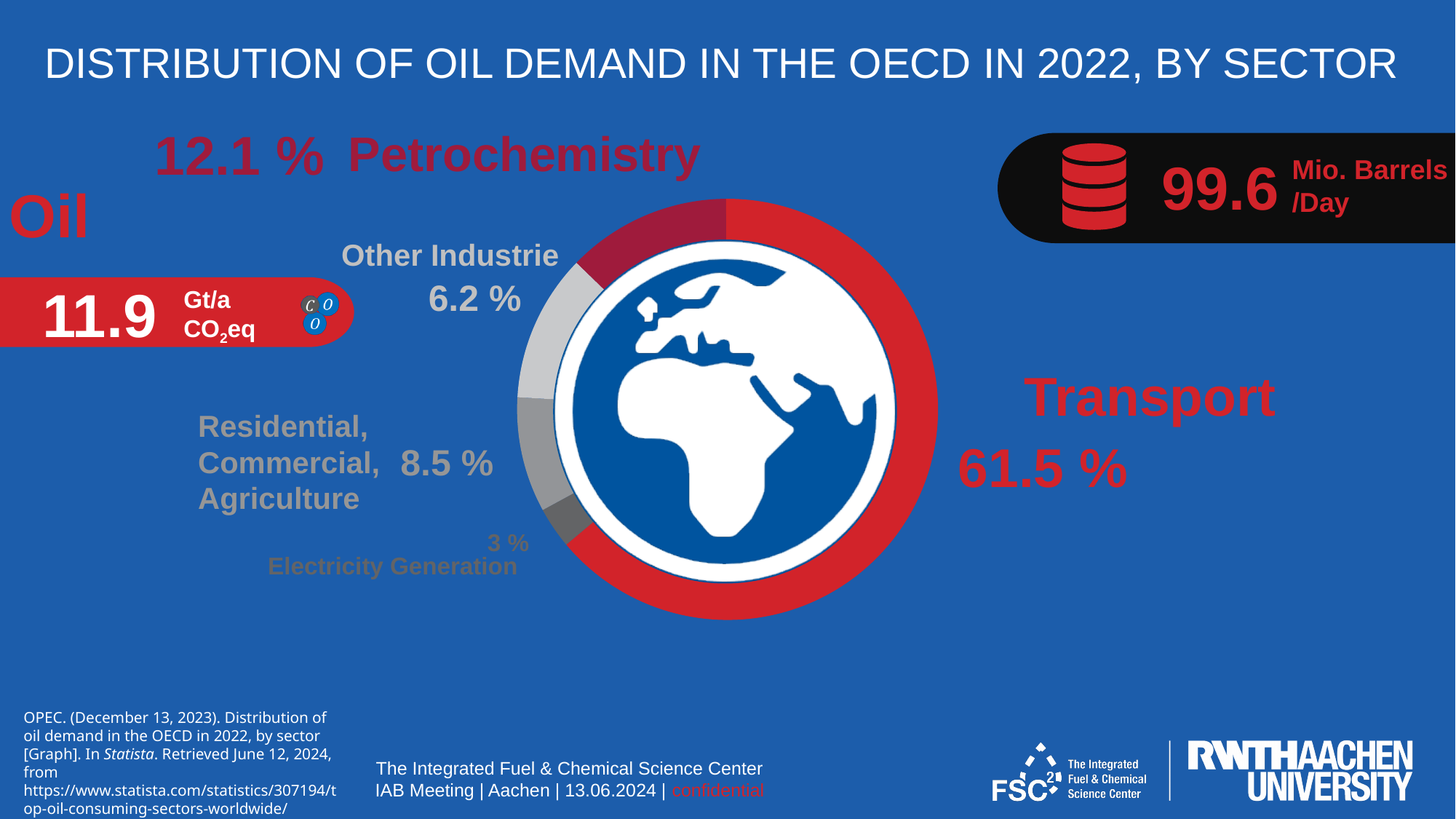
Which has a larger share: Other Industrie or Residential, Commercial, Agriculture? Residential, Commercial, Agriculture What share of OECD oil demand in 2022 does the Transport sector account for? 61.5 % How many percentage points larger is the Transport share than the Petrochemistry share? 49.4 % What daily oil volume in million barrels per day is shown on the slide? 99.6 What percentage is shown for Electricity Generation? 3 % How many sectors are shown in the chart? 5 What percentage is shown for Petrochemistry? 12.1 % Which sector has the largest share of oil demand in the chart? Transport What kind of chart is used to show the distribution of oil demand? Pie chart (donut) Which sector has the smallest share of oil demand in the chart? Electricity Generation What percentage is shown for Residential, Commercial, Agriculture? 8.5 % What percentage is shown for Other Industrie? 6.2 %